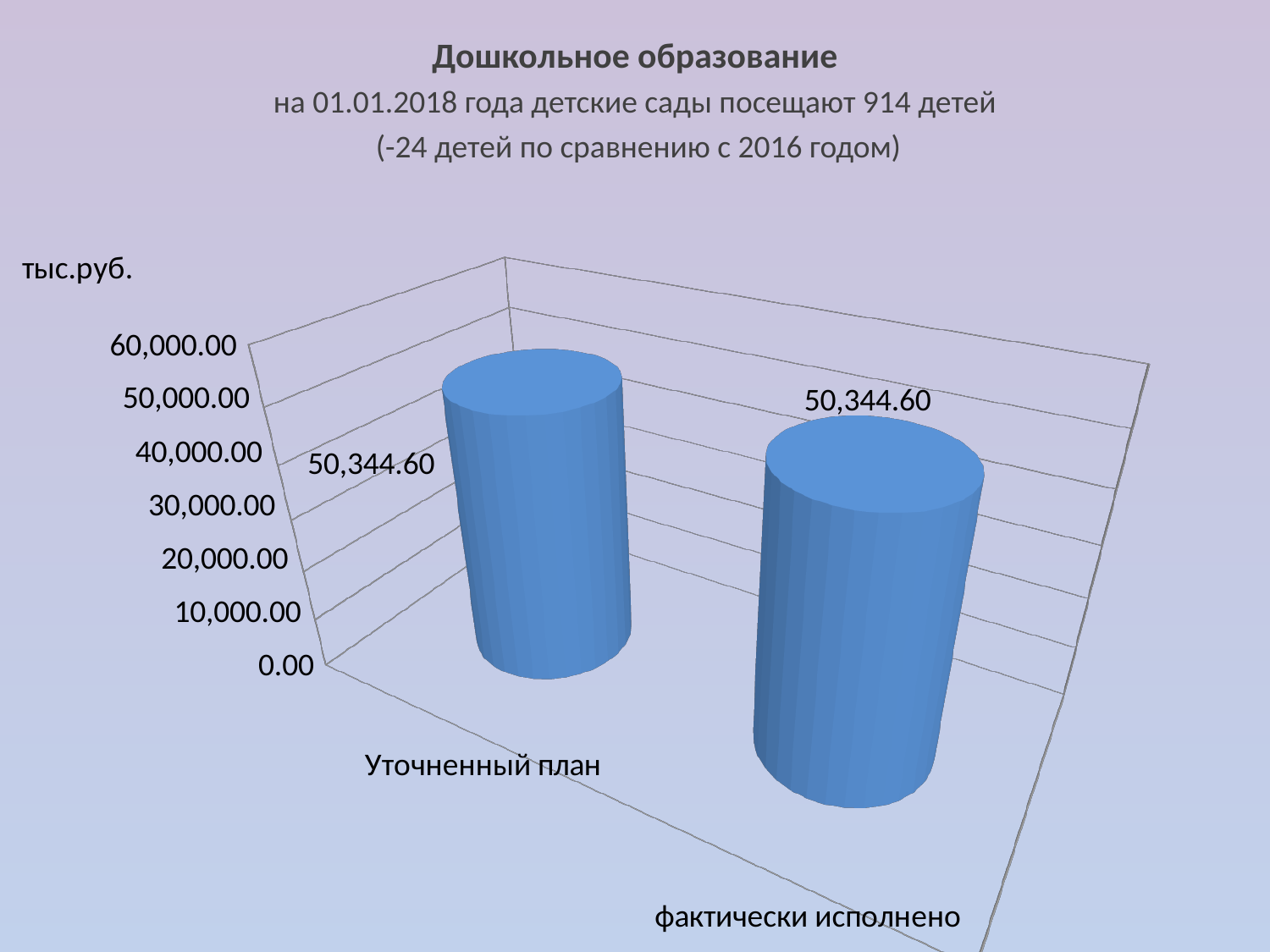
What kind of chart is shown on the slide? Bar chart How many categories are plotted in the chart? 2 Is the value for Уточненный план greater or less than 40,000.00? greater Is the value for фактически исполнено greater or less than 60,000.00? less What is the value for фактически исполнено? 50,344.60 What is the highest value shown on the vertical axis? 60,000.00 What unit is indicated for the values in the chart? тыс.руб. What is the difference between the values for Уточненный план and фактически исполнено? 0.00 Are the values for Уточненный план and фактически исполнено equal? Yes What is the value for Уточненный план? 50,344.60